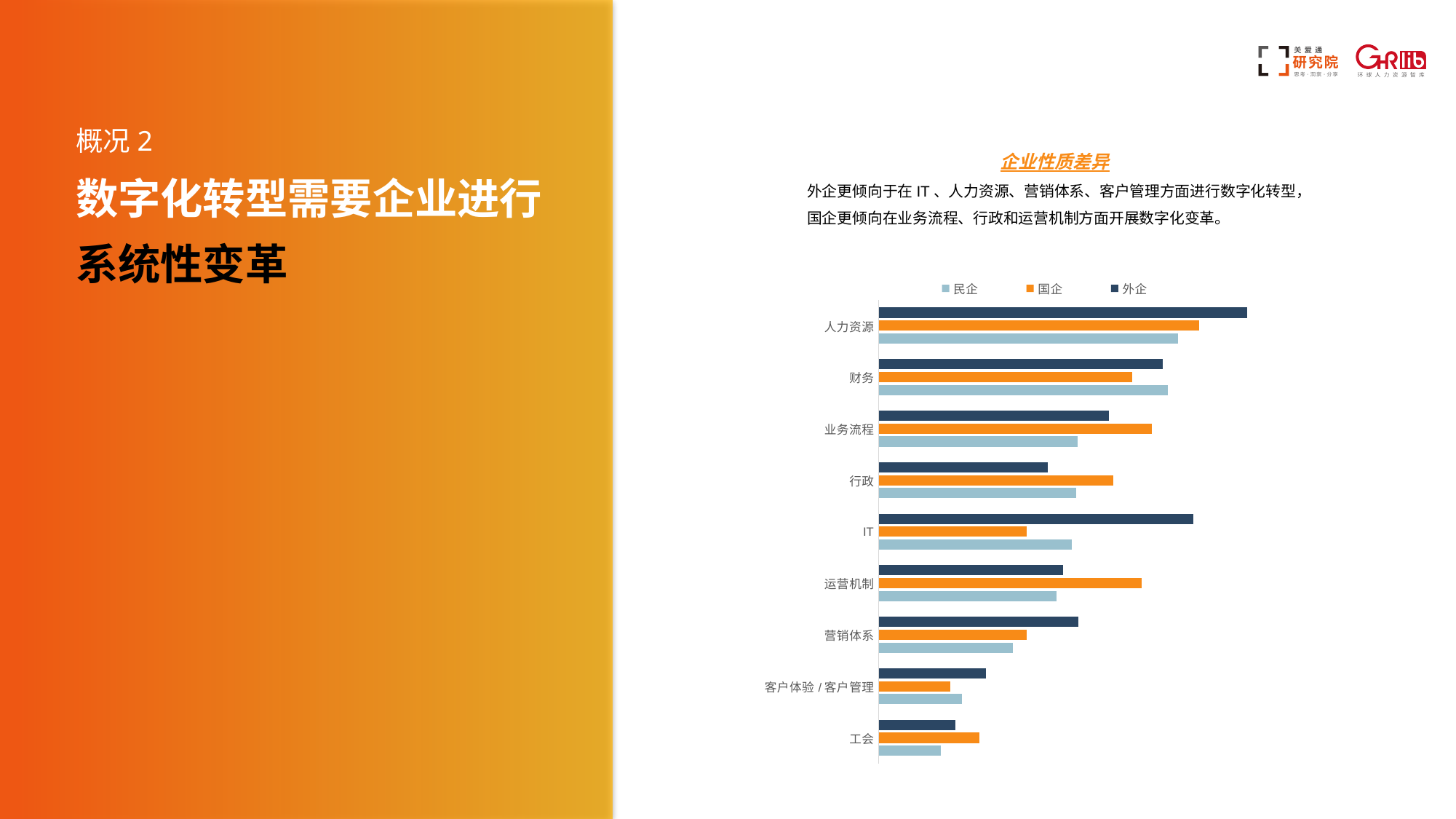
How many series does the chart legend list? 3 For the IT category, which is larger: the 外企 value or the 国企 value? 外企 For the 业务流程 category, which series has the highest value? 国企 For the 运营机制 category, which is larger: the 国企 value or the 外企 value? 国企 For the 国企 series, which category has the lowest value? 客户体验 / 客户管理 What is the heading shown above the chart? 企业性质差异 For the 外企 series, which category has the highest value? 人力资源 For the 国企 series, which category has the highest value? 人力资源 Which series are listed in the chart legend? 民企, 国企, 外企 For the 外企 series, which category has the lowest value? 工会 What kind of chart is shown on the slide? bar chart How many categories are plotted on the chart? 9